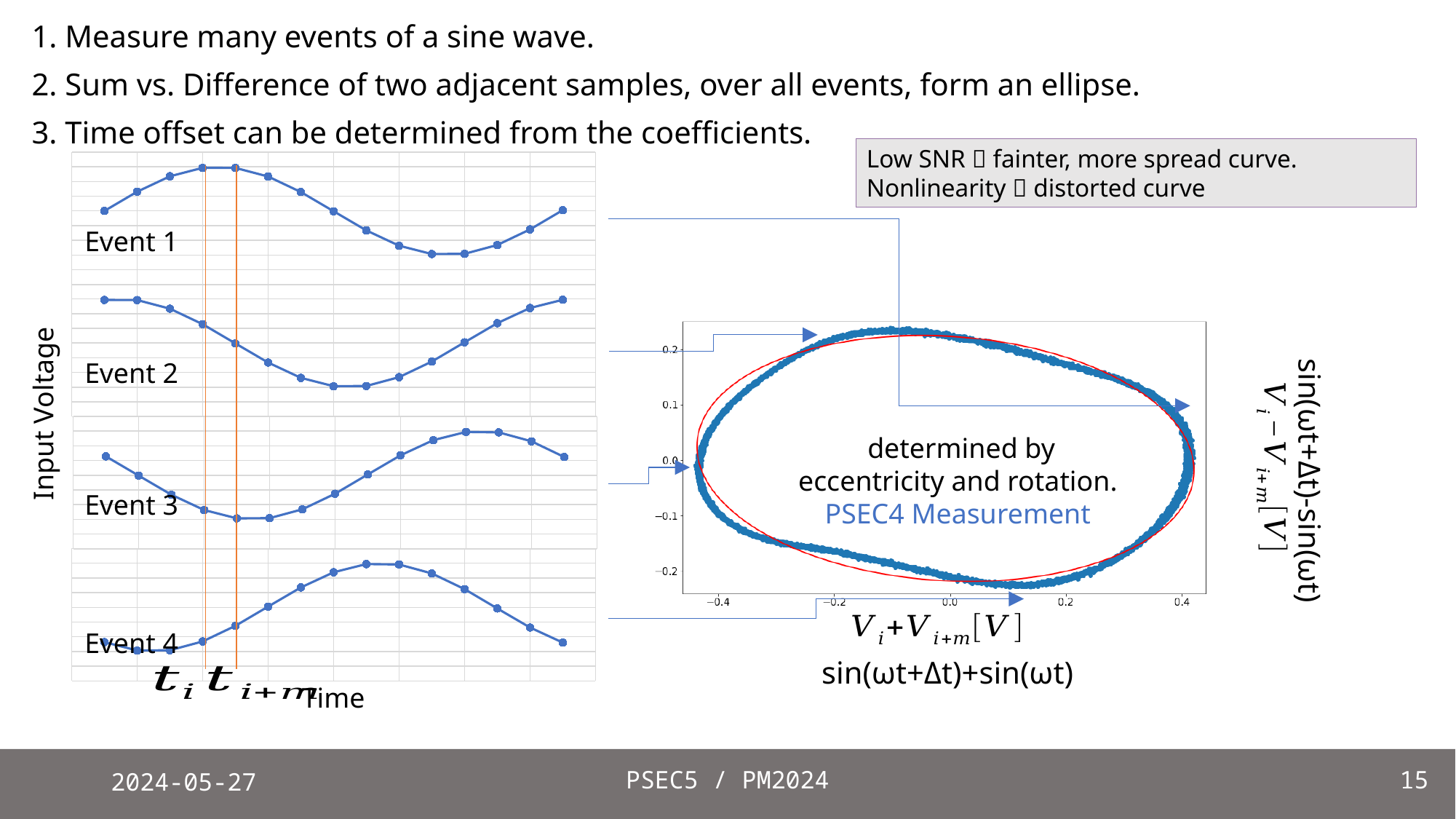
On the right chart (PSEC4 Measurement), is the smallest x value reached by the ellipse greater or less than -0.2? less On the left chart, how many vertical orange lines mark the sample times t_i and t_i+m? 2 What is the y-axis label of the left chart? Input Voltage What kind of chart is the right chart labelled PSEC4 Measurement? scatter chart On the right chart (PSEC4 Measurement), is the largest y value reached by the ellipse greater or less than 0.1? greater On the left chart, does Event 1 rise or fall between its first point and its peak near t_i? rise On the right chart (PSEC4 Measurement), is the smallest y value reached by the ellipse greater or less than -0.1? less What is the x-axis label of the left chart? Time What kind of chart is the left chart showing Event 1 to Event 4? line chart On the right chart (PSEC4 Measurement), what is the highest tick value shown on the x axis? 0.4 How many events (curves) are plotted on the left chart? 4